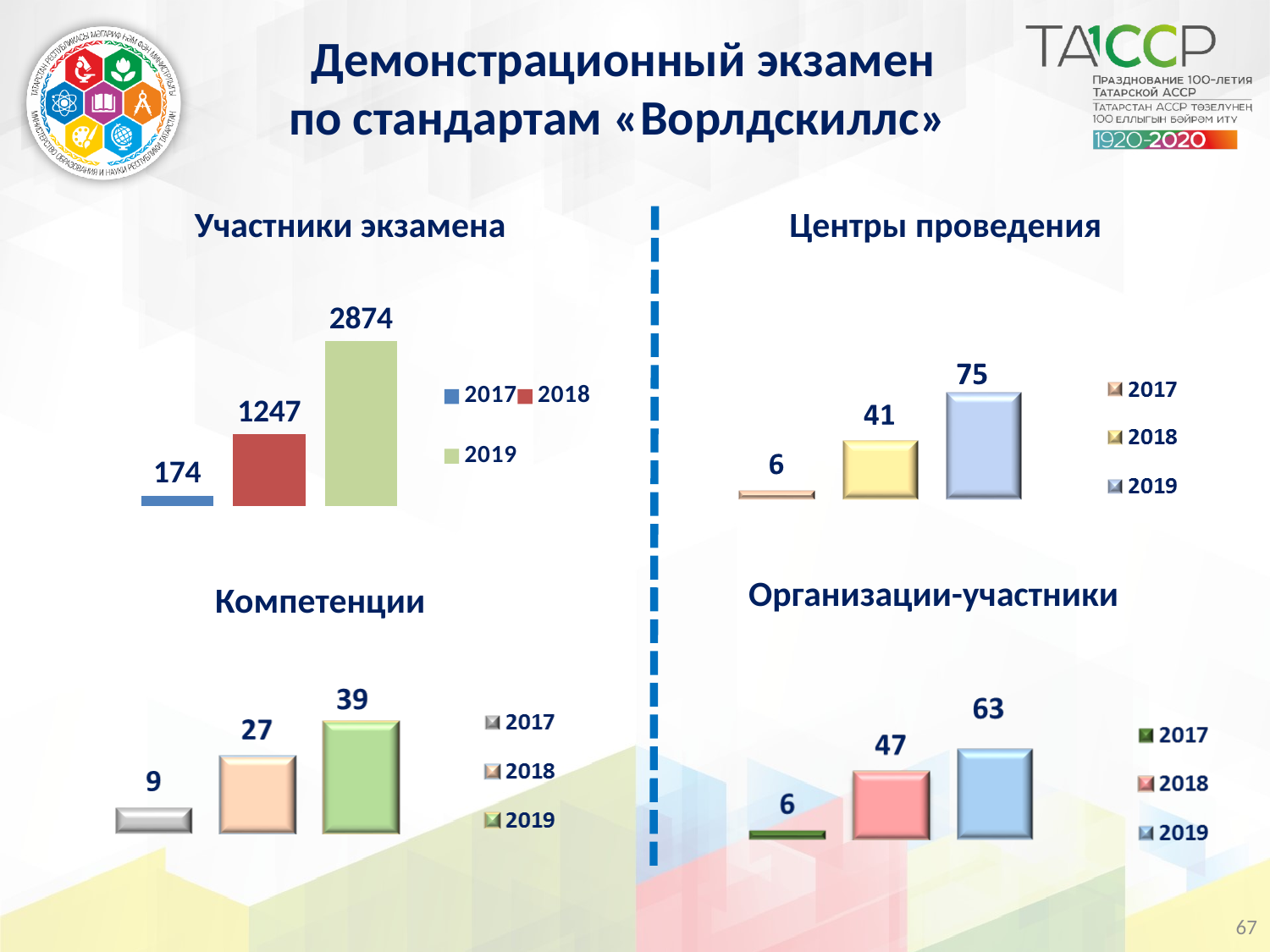
How many series does the legend of the 'Компетенции' chart list? 3 In the 'Участники экзамена' chart, what is the value for 2017? 174 In the 'Компетенции' chart, which year has the highest value? 2019 In the 'Центры проведения' chart, which year has the lowest value? 2017 In the 'Организации-участники' chart, which is larger, the value for 2018 or the value for 2019? 2019 In the 'Центры проведения' chart, what is the value for 2018? 41 In the 'Участники экзамена' chart, what is the value for 2019? 2874 In the 'Участники экзамена' chart, what is the difference between the 2019 and 2018 values? 1627 In the 'Центры проведения' chart, what is the difference between the 2019 and 2017 values? 69 In the 'Организации-участники' chart, do the values rise or fall from 2017 to 2019? rise In the 'Компетенции' chart, what is the value for 2019? 39 In the 'Организации-участники' chart, what is the value for 2018? 47